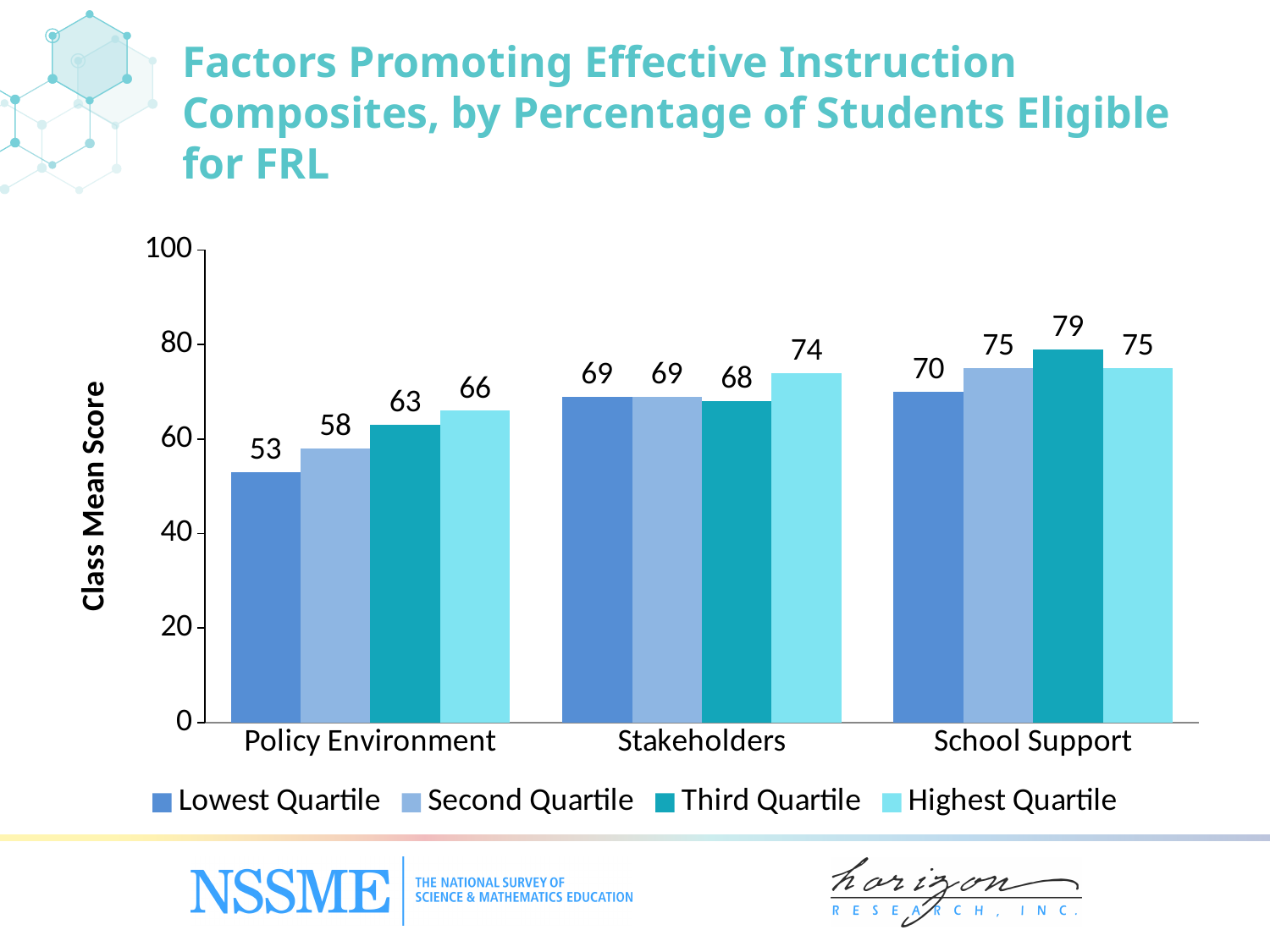
What is the label of the y axis? Class Mean Score Which is larger: the Second Quartile score for Stakeholders or the Second Quartile score for School Support? School Support Which quartile has the highest class mean score for Policy Environment? Highest Quartile What kind of chart is shown on the slide? Bar chart Is the Lowest Quartile score for School Support greater or less than 60? greater What is the difference between the Highest Quartile and Lowest Quartile scores for Policy Environment? 13 What is the class mean score for the Third Quartile in School Support? 79 Which quartile has the lowest class mean score for Stakeholders? Third Quartile How many series does the legend list? 4 How many categories are shown on the x axis? 3 What is the class mean score for the Lowest Quartile in Policy Environment? 53 What is the class mean score for the Highest Quartile in Stakeholders? 74